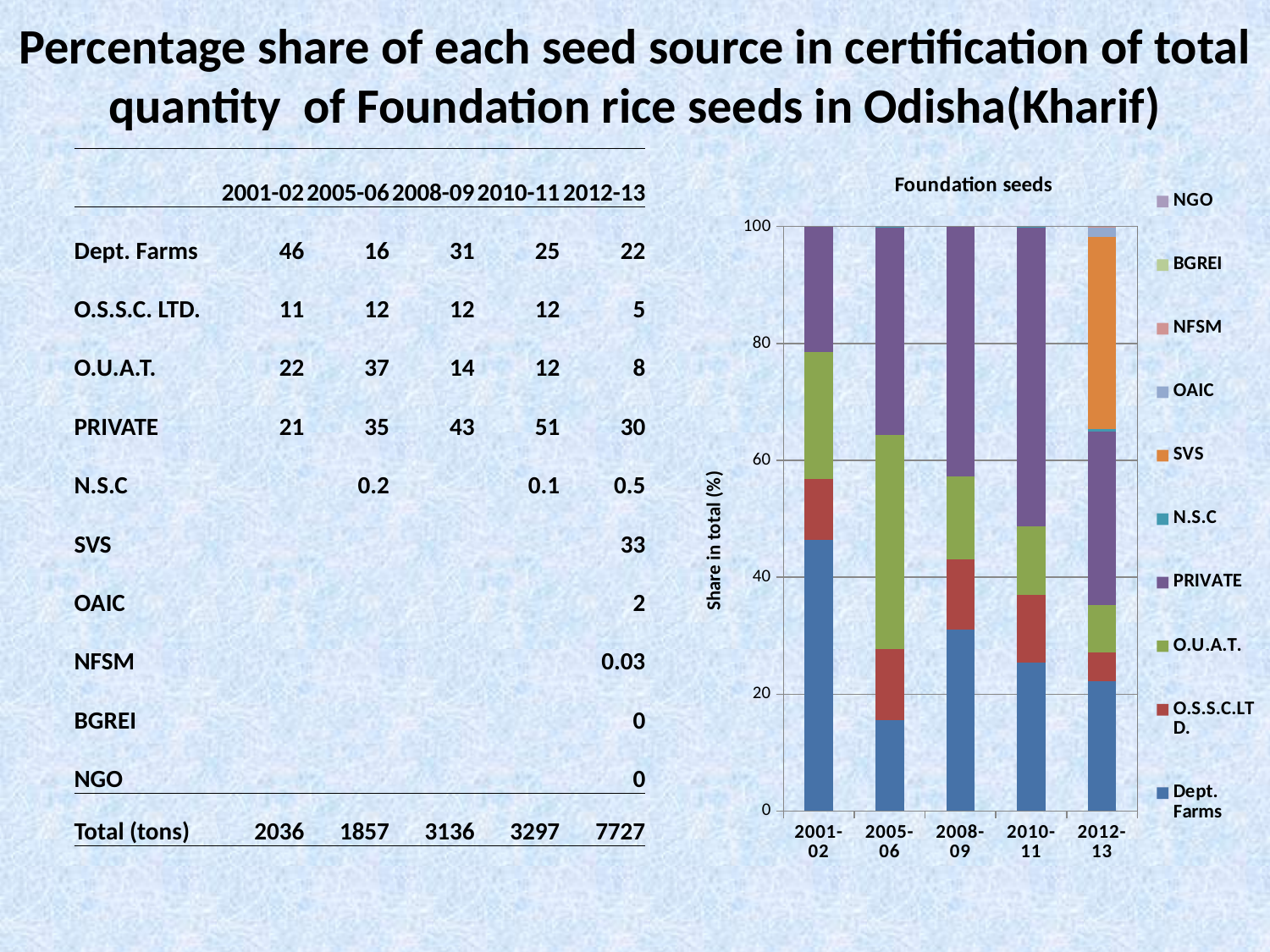
What is the share of SVS in 2012-13? 33 How many series does the legend of the "Foundation seeds" chart list? 10 In which year is the Dept. Farms share the lowest? 2005-06 In which year is the PRIVATE share the highest? 2010-11 What is the share of Dept. Farms in 2001-02? 46 Is the Dept. Farms share in 2001-02 greater or less than 40? greater What is the title of the y axis on the "Foundation seeds" chart? Share in total (%) How many year categories are shown on the x axis of the "Foundation seeds" chart? 5 Which year has the larger O.U.A.T. share, 2005-06 or 2012-13? 2005-06 What is the share of PRIVATE in 2010-11? 51 What is the difference between the PRIVATE share in 2010-11 and in 2001-02? 30 What kind of chart is the "Foundation seeds" chart? stacked bar chart